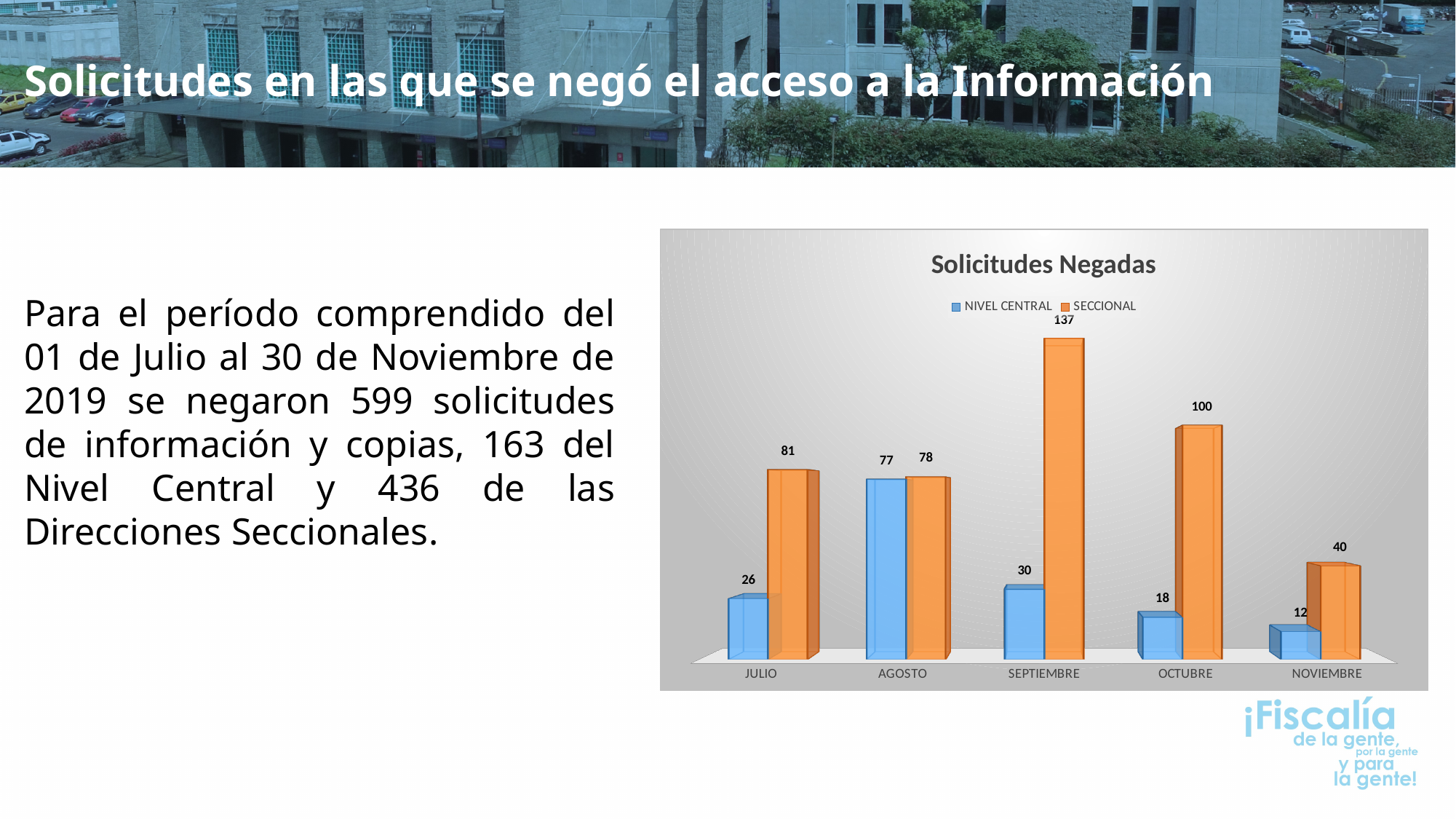
What is the difference between the SECCIONAL and NIVEL CENTRAL values in OCTUBRE? 82 What is the value for SECCIONAL in SEPTIEMBRE? 137 How many months are shown on the x axis? 5 Which month has the highest SECCIONAL value? SEPTIEMBRE What is the title of the chart? Solicitudes Negadas Which month has the lowest NIVEL CENTRAL value? NOVIEMBRE What kind of chart is shown? Bar chart What is the value for SECCIONAL in NOVIEMBRE? 40 Does the NIVEL CENTRAL value rise or fall from SEPTIEMBRE to NOVIEMBRE? Fall How many series does the legend list? 2 Which is larger in AGOSTO, NIVEL CENTRAL or SECCIONAL? SECCIONAL What is the value for NIVEL CENTRAL in JULIO? 26